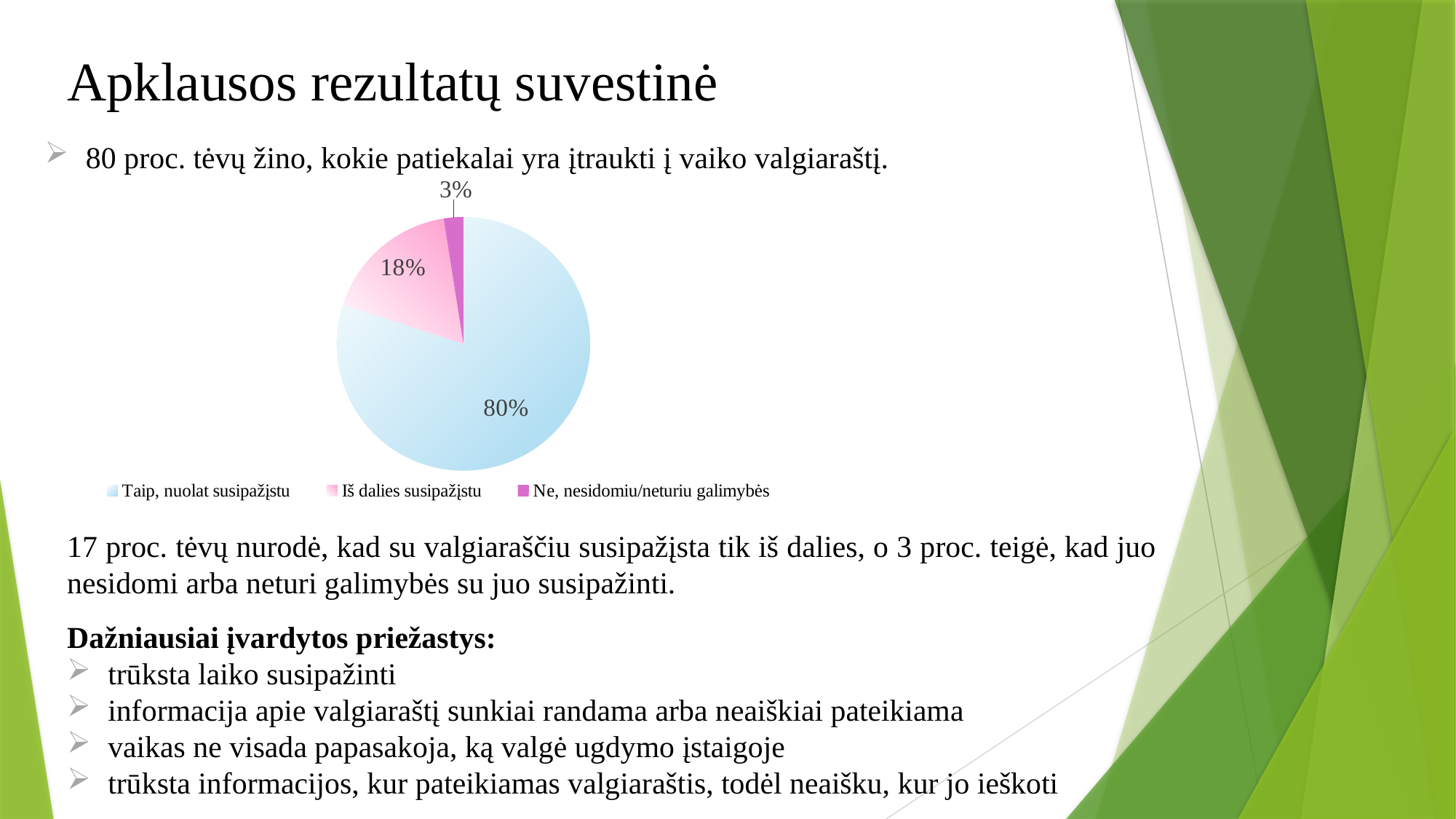
Which category has the largest slice of the pie? Taip, nuolat susipažįstu How many slices does the pie chart have? 3 What kind of chart is shown on the slide? pie chart Which category has the smallest slice of the pie? Ne, nesidomiu/neturiu galimybės What is the difference between the "Taip, nuolat susipažįstu" slice and the "Iš dalies susipažįstu" slice? 62% What colour is the "Taip, nuolat susipažįstu" slice in the pie chart? light blue What is the difference between the "Iš dalies susipažįstu" slice and the "Ne, nesidomiu/neturiu galimybės" slice? 15% What share of the pie does "Ne, nesidomiu/neturiu galimybės" take? 3% Which is larger: the "Iš dalies susipažįstu" slice or the "Ne, nesidomiu/neturiu galimybės" slice? Iš dalies susipažįstu How many entries does the legend list? 3 What share of the pie does "Taip, nuolat susipažįstu" take? 80% What share of the pie does "Iš dalies susipažįstu" take? 18%